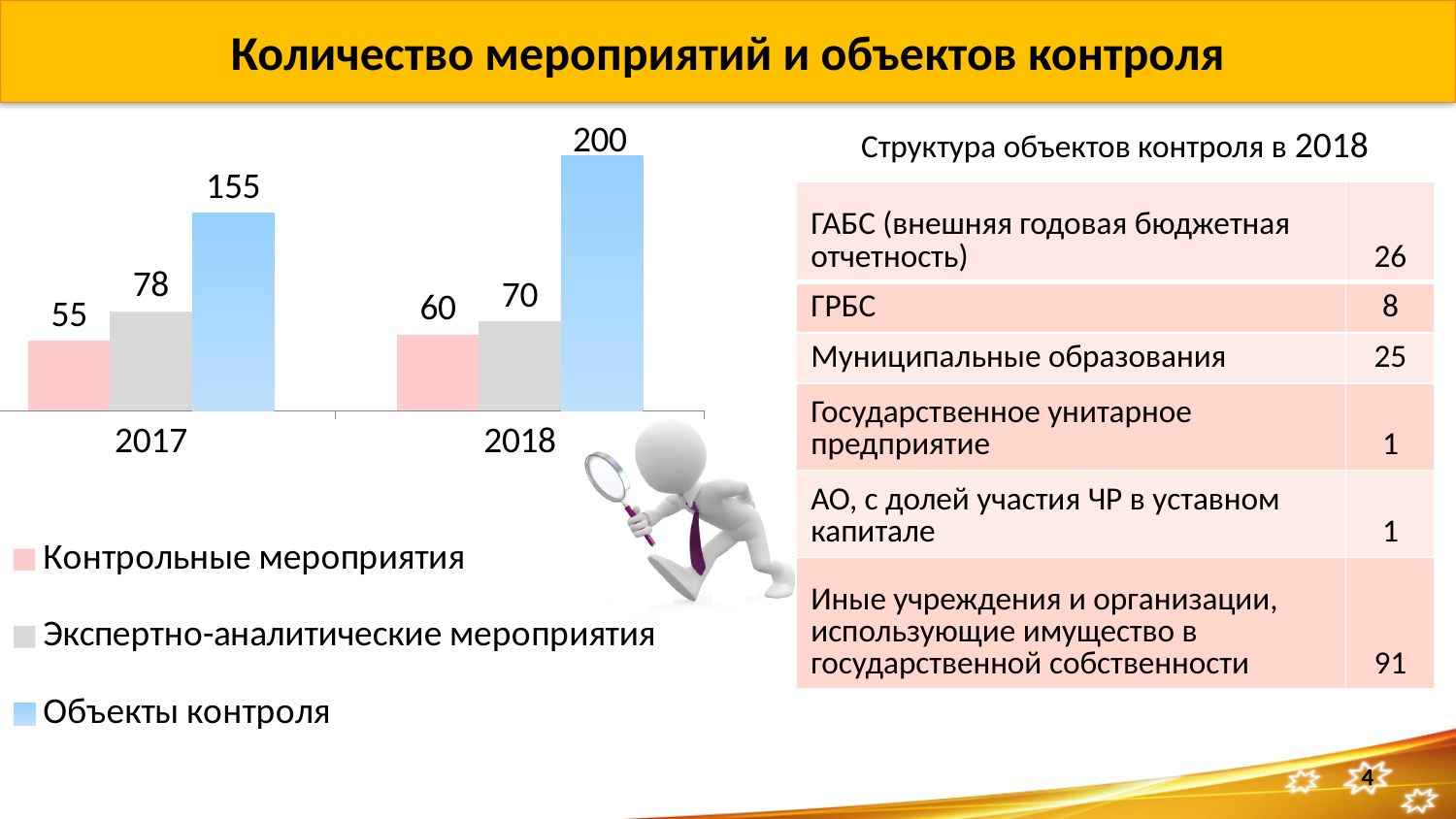
Which is larger: Экспертно-аналитические мероприятия in 2017 or in 2018? 2017 Which series has the lowest value in 2017? Контрольные мероприятия How many series does the legend list? 3 What kind of chart is shown on the slide? Bar chart What is the difference between the Объекты контроля values for 2018 and 2017? 45 What is the value for Контрольные мероприятия in 2017? 55 Which series has the highest value in 2018? Объекты контроля What is the value for Объекты контроля in 2018? 200 What is the difference between Экспертно-аналитические мероприятия and Контрольные мероприятия in 2017? 23 What is the value for Объекты контроля in 2017? 155 What is the value for Экспертно-аналитические мероприятия in 2018? 70 Does the value for Контрольные мероприятия rise or fall from 2017 to 2018? Rise